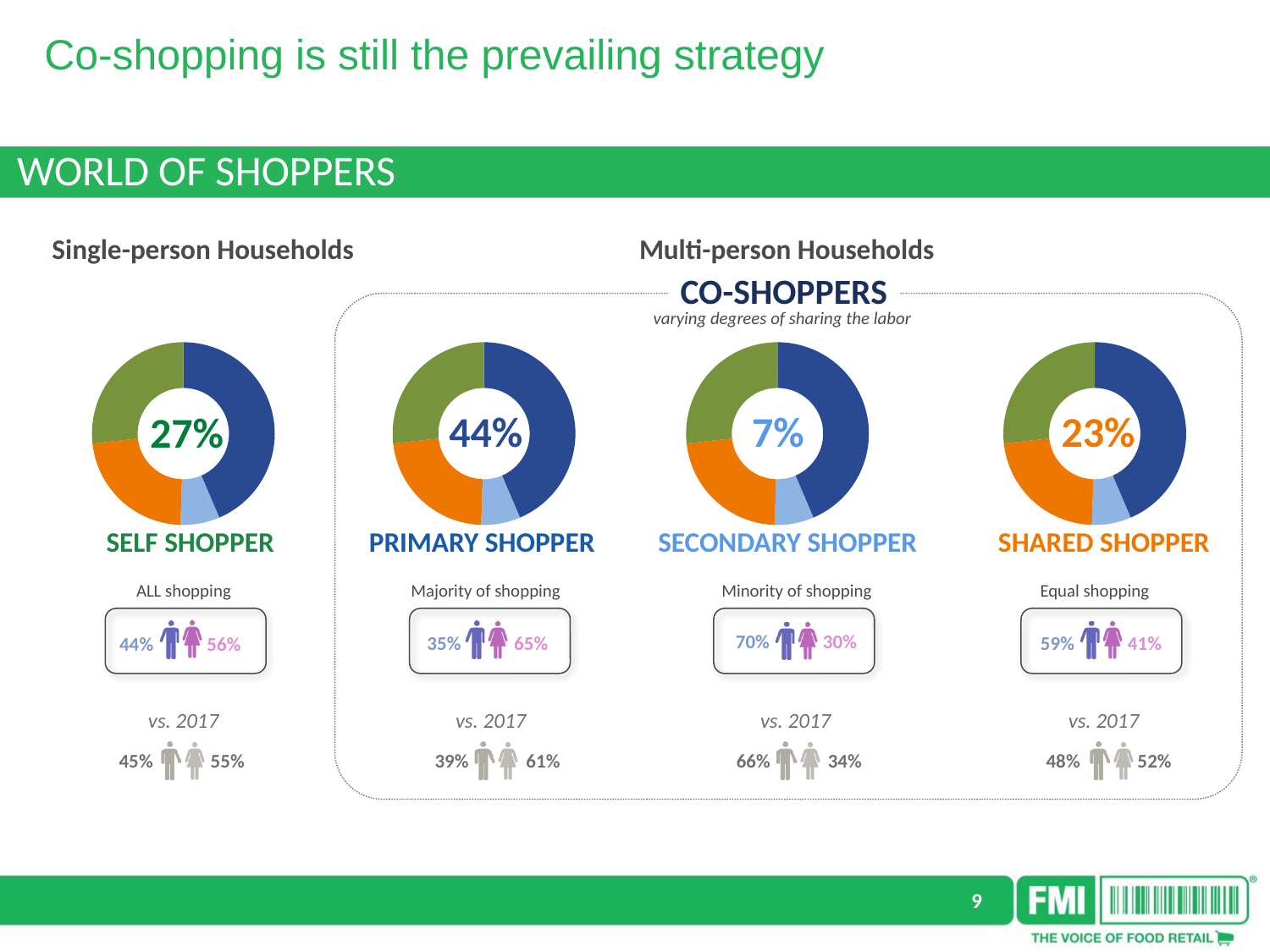
Which is larger, the Self Shopper percentage or the Shared Shopper percentage? Self Shopper What percentage is shown in the centre of the Shared Shopper donut chart? 23% What percentage is shown in the centre of the Self Shopper donut chart? 27% How many donut charts are shown on the slide? 4 What kind of chart is used to show each shopper type's percentage? Donut (pie) chart Which shopper type has the highest percentage shown in its donut chart? Primary Shopper Which shopper type has the lowest percentage shown in its donut chart? Secondary Shopper How many shopper types are grouped under the Co-Shoppers heading? 3 What percentage is shown in the centre of the Secondary Shopper donut chart? 7% What is the difference between the Self Shopper percentage and the Shared Shopper percentage? 4% What percentage is shown in the centre of the Primary Shopper donut chart? 44% What is the difference between the Primary Shopper percentage and the Secondary Shopper percentage? 37%